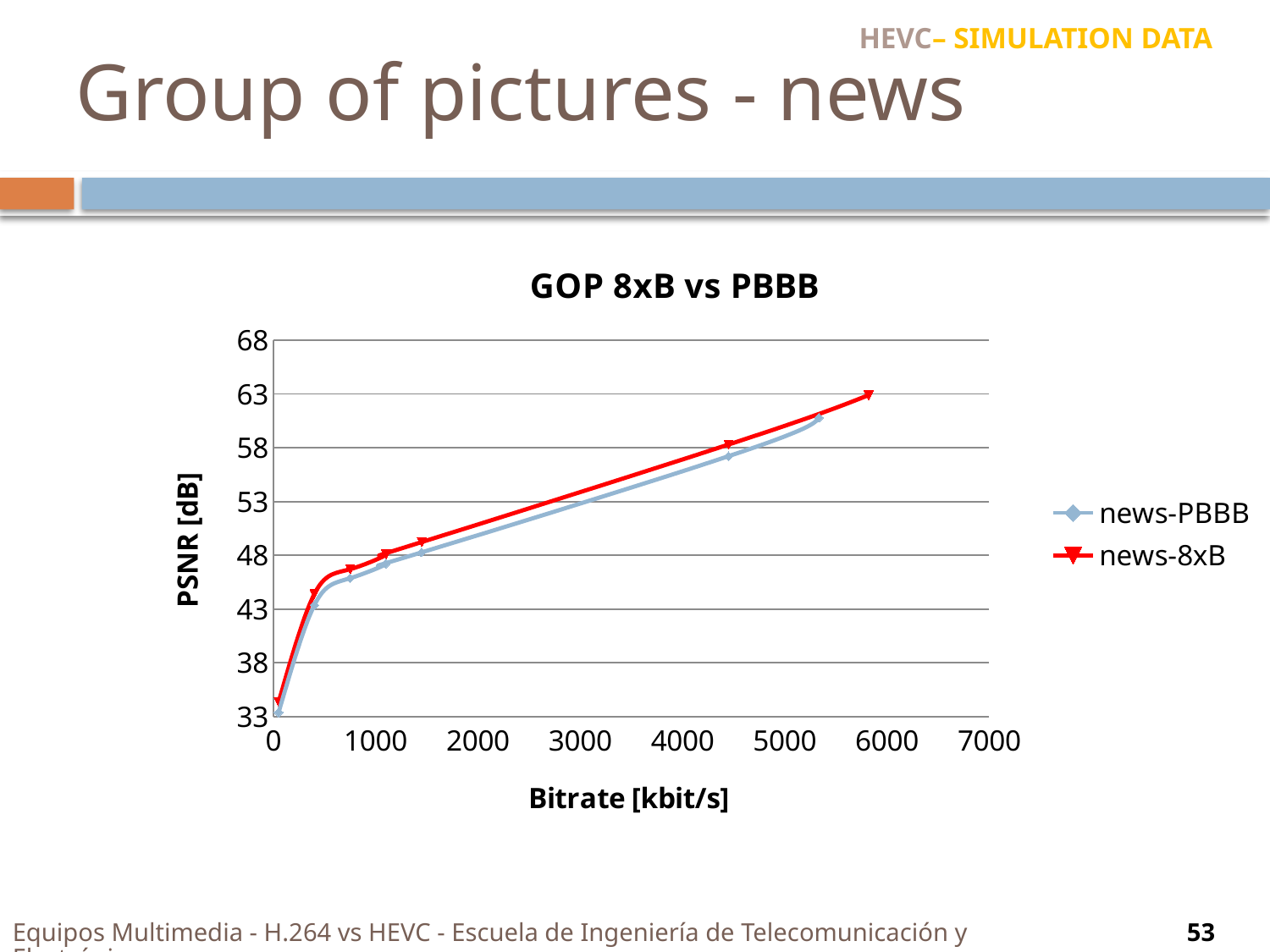
What kind of chart is shown on the slide? line chart Is the highest bitrate plotted for news-PBBB greater or less than 6000 kbit/s? less Which series has the lower PSNR at its first (lowest-bitrate) point? news-PBBB At a bitrate of around 4500 kbit/s, which series has the higher PSNR, news-PBBB or news-8xB? news-8xB Which series reaches the highest PSNR value? news-8xB How many series does the legend list? 2 What is the label of the vertical axis? PSNR [dB] What is the title of the chart? GOP 8xB vs PBBB Is the highest bitrate plotted for news-8xB greater or less than 5000 kbit/s? greater Do the PSNR values rise or fall as the bitrate increases? rise Is the highest PSNR value of news-8xB greater or less than 58? greater